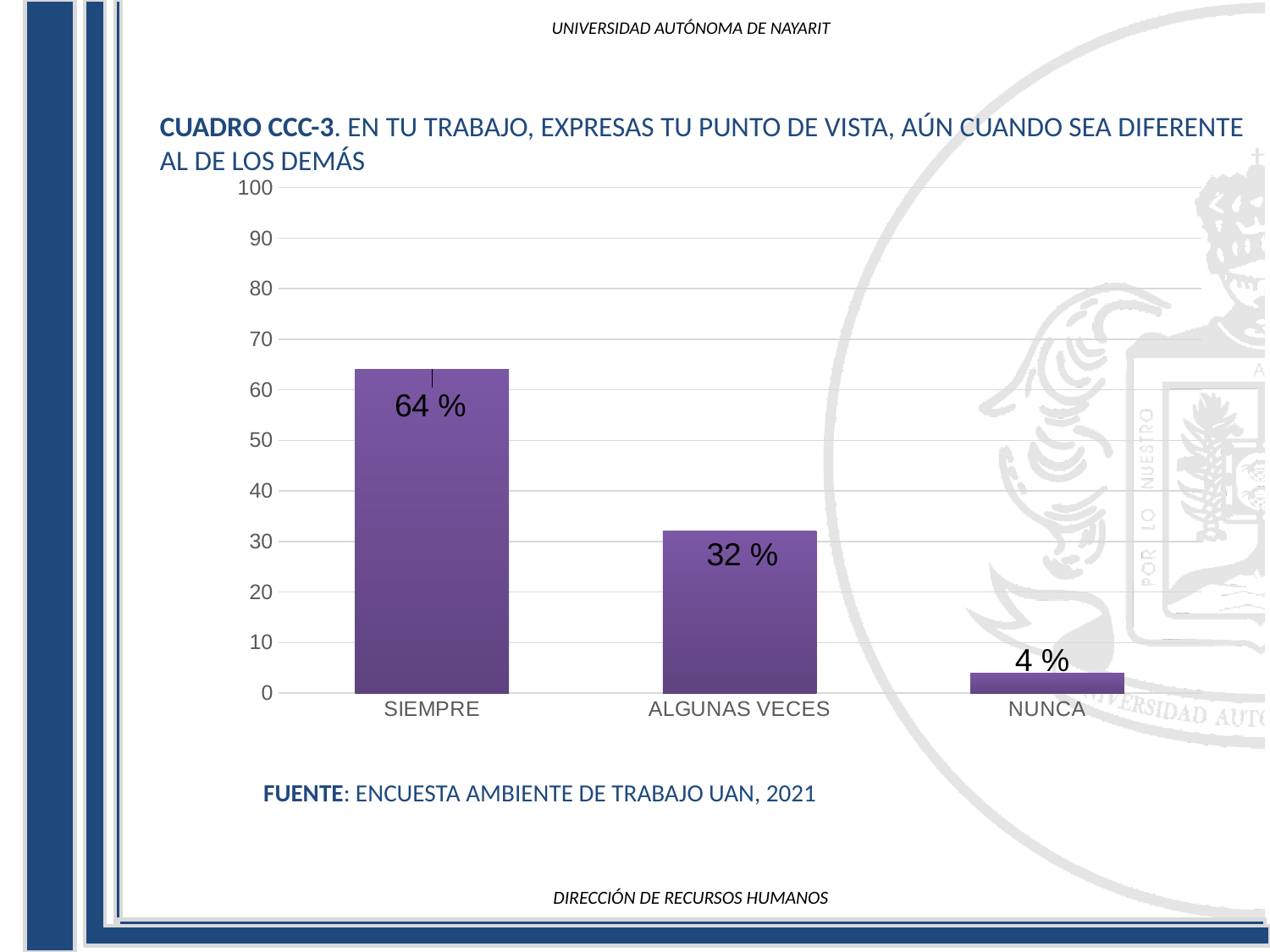
What is the value for NUNCA? 4 % What kind of chart is shown on the slide? bar chart Do the values rise or fall from left to right along the x axis? fall What is the value for ALGUNAS VECES? 32 % Which is larger, the value for ALGUNAS VECES or the value for NUNCA? ALGUNAS VECES What is the difference between the values for SIEMPRE and ALGUNAS VECES? 32 % Which category has the highest value? SIEMPRE What is the difference between the values for ALGUNAS VECES and NUNCA? 28 % Which category has the lowest value? NUNCA How many categories are shown on the x axis? 3 What is the value for SIEMPRE? 64 % Is the value for SIEMPRE greater or less than 50? greater